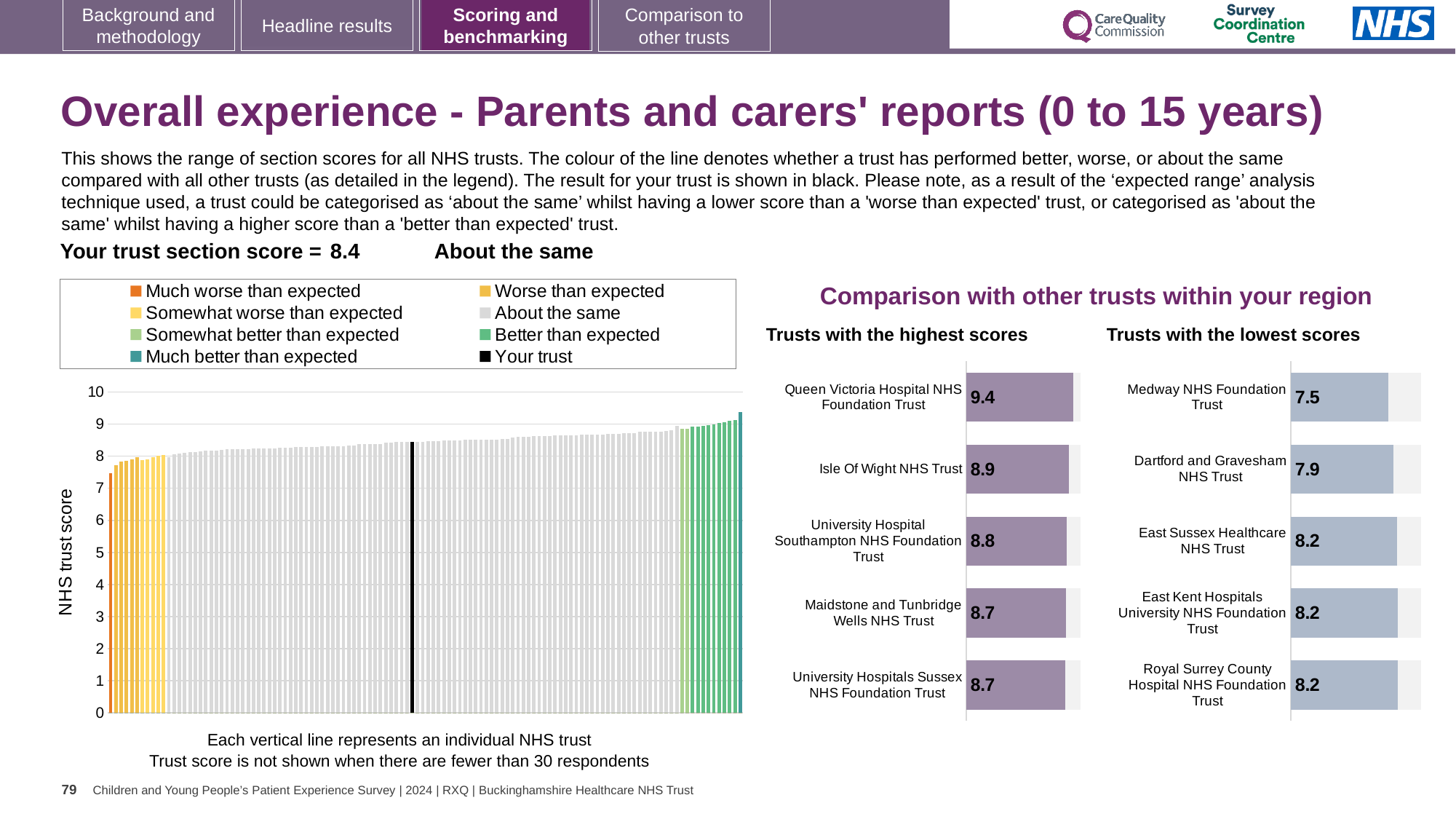
In the 'Trusts with the lowest scores' chart, which trust has the lowest score? Medway NHS Foundation Trust In the 'Trusts with the highest scores' chart, what is the difference between the scores of Queen Victoria Hospital NHS Foundation Trust and Isle Of Wight NHS Trust? 0.5 In the 'Trusts with the lowest scores' chart, what is the score for Medway NHS Foundation Trust? 7.5 In the 'Trusts with the highest scores' chart, what is the score for Queen Victoria Hospital NHS Foundation Trust? 9.4 Which is larger: the score for Isle Of Wight NHS Trust in the 'Trusts with the highest scores' chart or the score for East Sussex Healthcare NHS Trust in the 'Trusts with the lowest scores' chart? Isle Of Wight NHS Trust In the 'Trusts with the lowest scores' chart, what is the score for Dartford and Gravesham NHS Trust? 7.9 In the 'Trusts with the highest scores' chart, what is the score for University Hospital Southampton NHS Foundation Trust? 8.8 What kind of chart is the main 'NHS trust score' chart on the left of the slide? Bar chart How many trusts are shown in the 'Trusts with the highest scores' chart? 5 In the 'Trusts with the highest scores' chart, which trust has the highest score? Queen Victoria Hospital NHS Foundation Trust In the 'Trusts with the lowest scores' chart, what is the difference between the scores of Dartford and Gravesham NHS Trust and Medway NHS Foundation Trust? 0.4 In the main 'NHS trust score' chart on the left, is the value of the black bar (your trust) greater or less than 8? greater